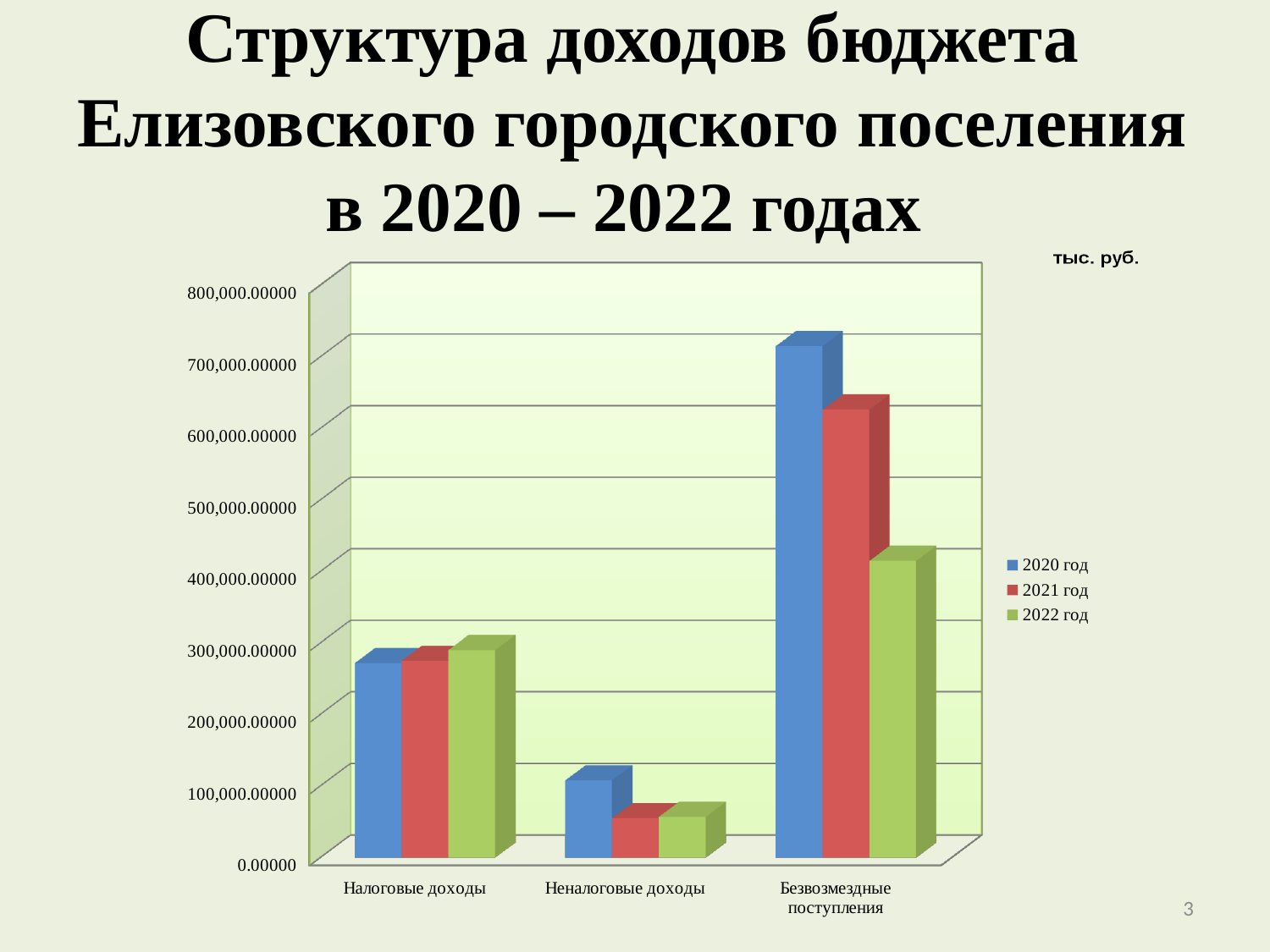
Which category has the highest value for the 2020 год series? Безвозмездные поступления Is the 2021 год value for Неналоговые доходы greater or less than 100,000.00000? less For Безвозмездные поступления, which is larger: the 2020 год value or the 2022 год value? 2020 год Do the values for Безвозмездные поступления rise or fall from 2020 год to 2022 год? fall Is the 2020 год value for Безвозмездные поступления greater or less than 600,000.00000? greater Is the 2022 год value for Безвозмездные поступления greater or less than 500,000.00000? less What unit label is shown above the chart's legend? тыс. руб. How many series does the chart legend list? 3 What kind of chart is shown on the slide? bar chart For Неналоговые доходы, which is larger: the 2020 год value or the 2021 год value? 2020 год Which category has the lowest value for the 2021 год series? Неналоговые доходы How many categories are shown on the x axis of the chart? 3